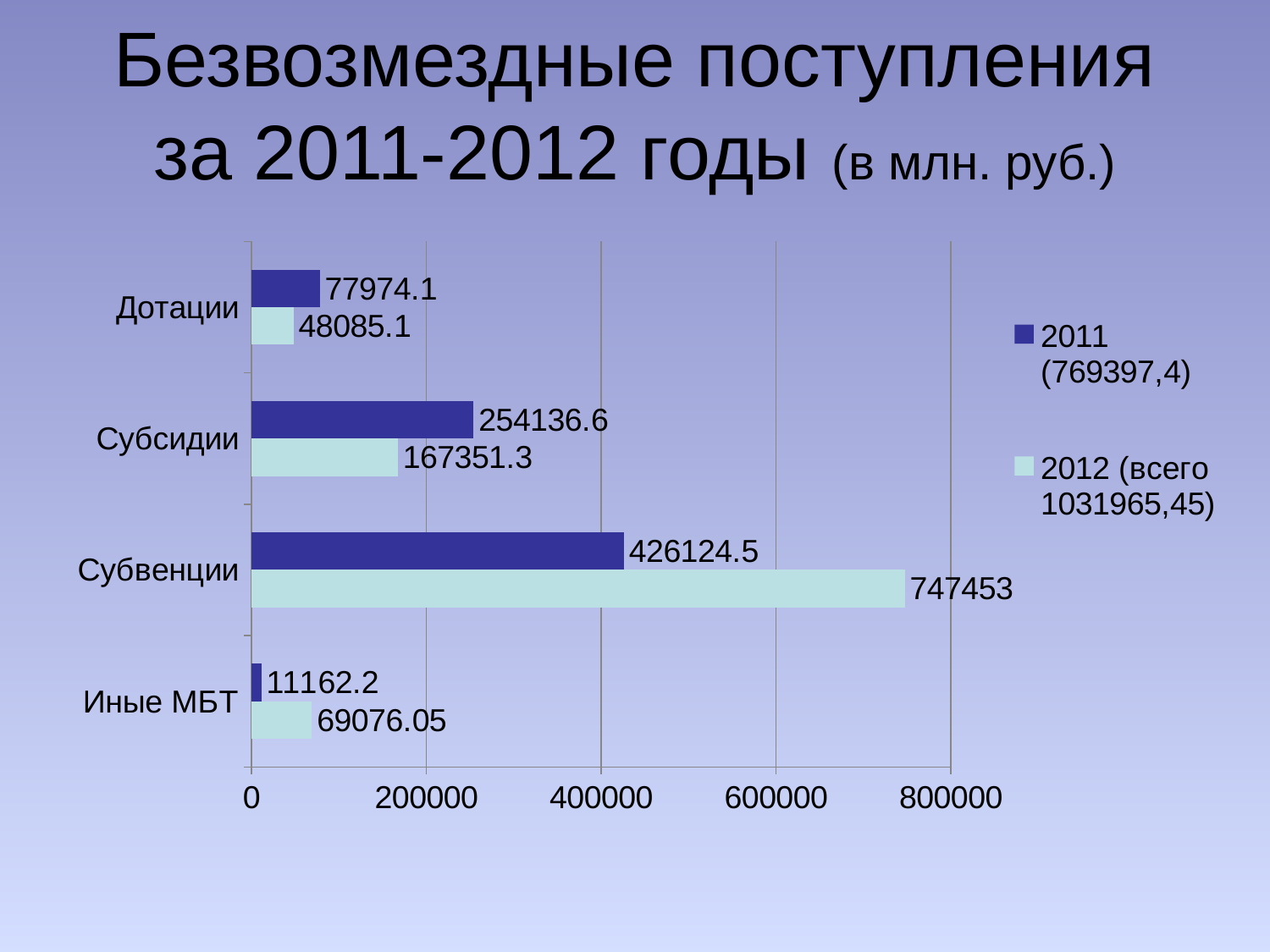
How many series does the legend list? 2 What is the 2012 value for Дотации? 48085.1 What is the difference between the 2011 and 2012 values for Дотации? 29889 Which category has the highest 2012 value? Субвенции What is the 2011 value for Субсидии? 254136.6 What kind of chart is shown on the slide? Bar chart What is the 2011 value for Субвенции? 426124.5 What is the difference between the 2012 and 2011 values for Субвенции? 321328.5 Which is larger for Субсидии, the 2011 value or the 2012 value? 2011 Which category has the lowest 2011 value? Иные МБТ How many categories are shown on the chart? 4 What is the 2012 value for Иные МБТ? 69076.05